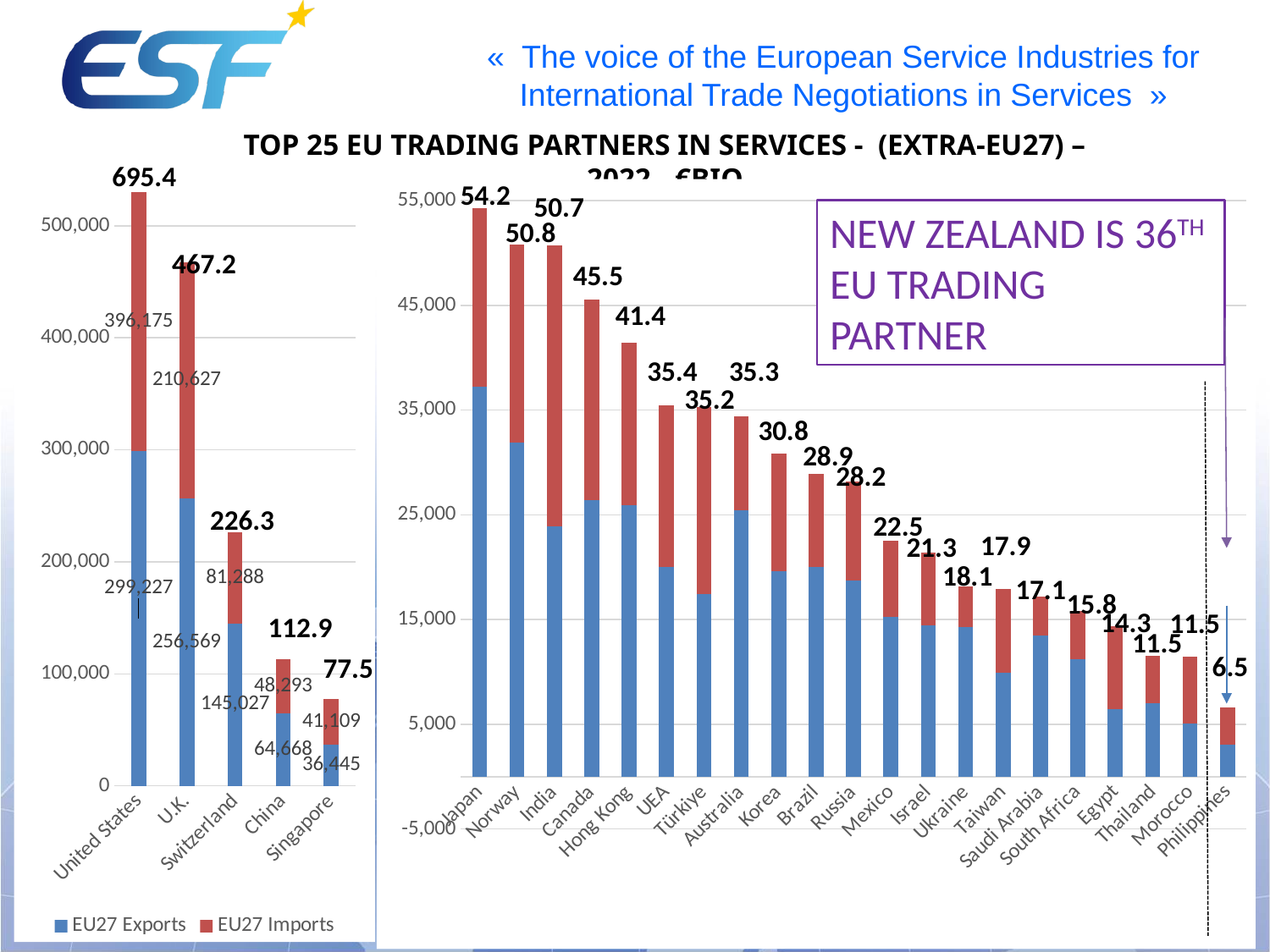
On the left chart, what colour represents EU27 Imports? Red On the left chart, what is the EU27 Exports value for the U.K.? 256,569 On the right chart, which country has the highest total value? Japan On the right chart, which is larger, the total for Brazil or the total for Mexico? Brazil On the right chart, what is the difference between the totals for Japan and Philippines? 47.7 On the right chart, what is the total value labelled for Canada? 45.5 On the left chart, what is the EU27 Imports value for Switzerland? 81,288 On the left chart, how many series does the legend list? 2 On the left chart, what is the total value labelled above the United States bar? 695.4 On the left chart, what is the difference between the total values for the U.K. and Switzerland? 240.9 What kind of chart is the right chart? Stacked bar chart On the left chart, which country has the lowest total value? Singapore